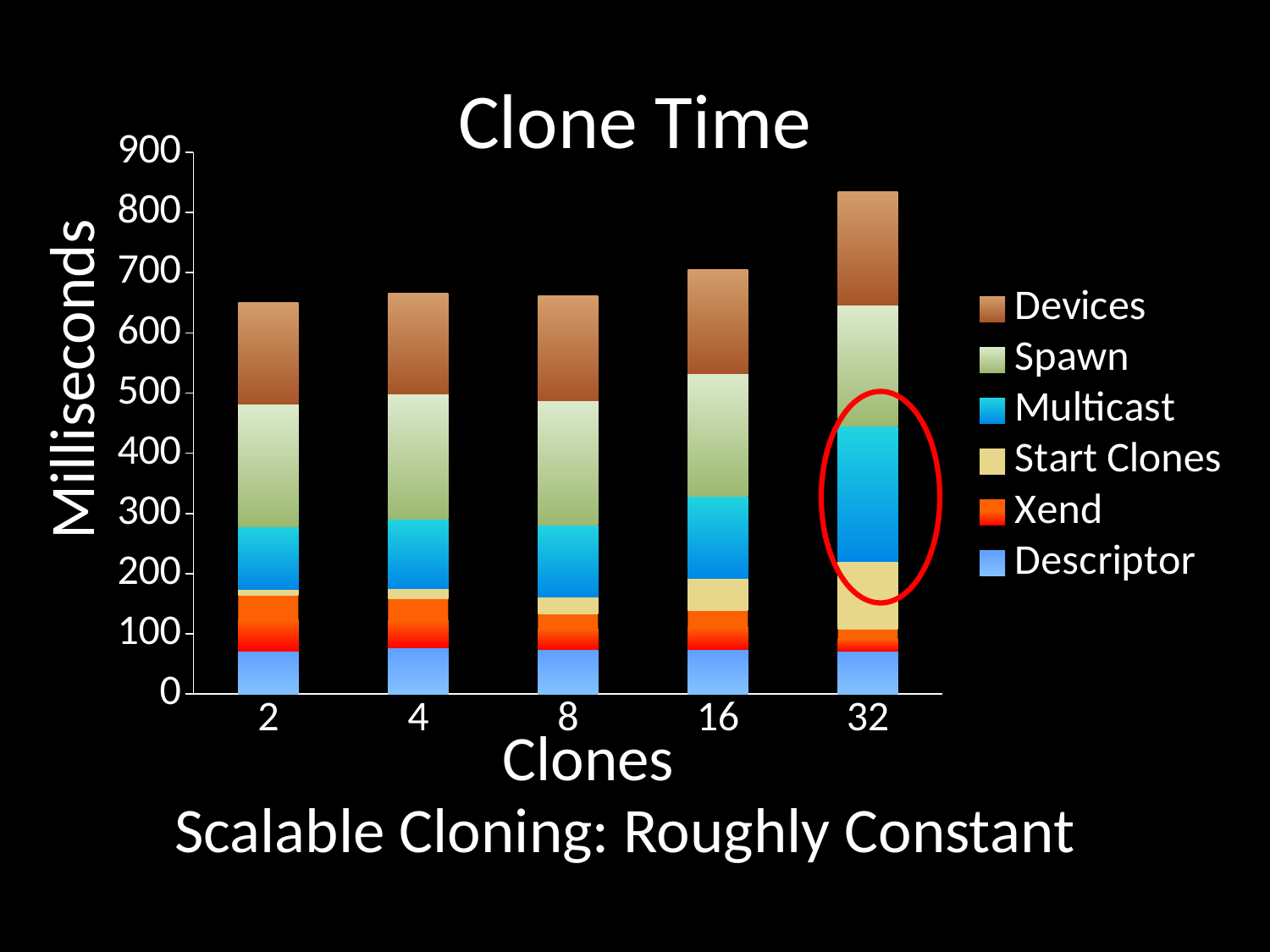
Is the total clone time for 16 clones greater or less than 800 milliseconds? less What is the label on the y axis? Milliseconds What is the title of the chart? Clone Time How many series does the legend list? 6 Is the total clone time for 2 clones greater or less than 700 milliseconds? less Is the total clone time for 32 clones greater or less than 800 milliseconds? greater What kind of chart is shown on the slide? Stacked bar chart Which has a larger total clone time, 2 clones or 16 clones? 16 clones How many clone counts (categories) are shown on the x axis? 5 Does the total clone time rise or fall from 16 clones to 32 clones? Rise Which has a larger total clone time, 16 clones or 32 clones? 32 clones Which clone count has the highest total clone time? 32